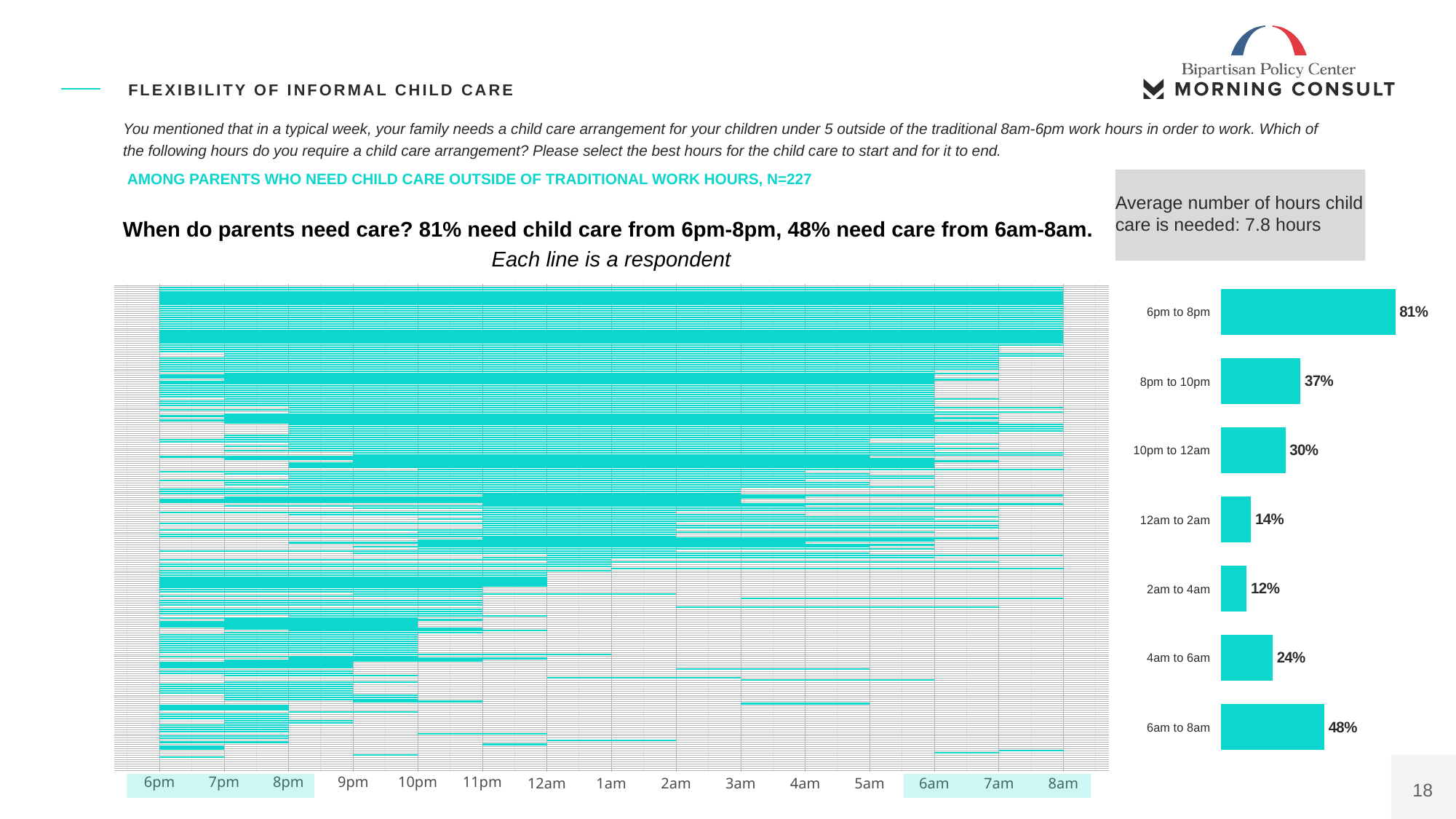
In the bar chart on the right, which is larger: the value for 8pm to 10pm or the value for 6am to 8am? 6am to 8am In the bar chart on the right, what is the difference in percentage points between 6pm to 8pm and 6am to 8am? 33 percentage points In the chart on the left, what does each line represent according to its subtitle? A respondent In the bar chart on the right, what is the difference in percentage points between 10pm to 12am and 12am to 2am? 16 percentage points In the bar chart on the right, what is the value for 12am to 2am? 14% In the bar chart on the right, which time slot has the lowest percentage? 2am to 4am How many time slots are shown in the bar chart on the right? 7 In the bar chart on the right, what percentage of parents need child care from 6pm to 8pm? 81% In the bar chart on the right, what percentage of parents need child care from 6am to 8am? 48% In the bar chart on the right, what is the value for 4am to 6am? 24% What kind of chart is the chart on the right of the slide? Bar chart In the bar chart on the right, which time slot has the highest percentage? 6pm to 8pm